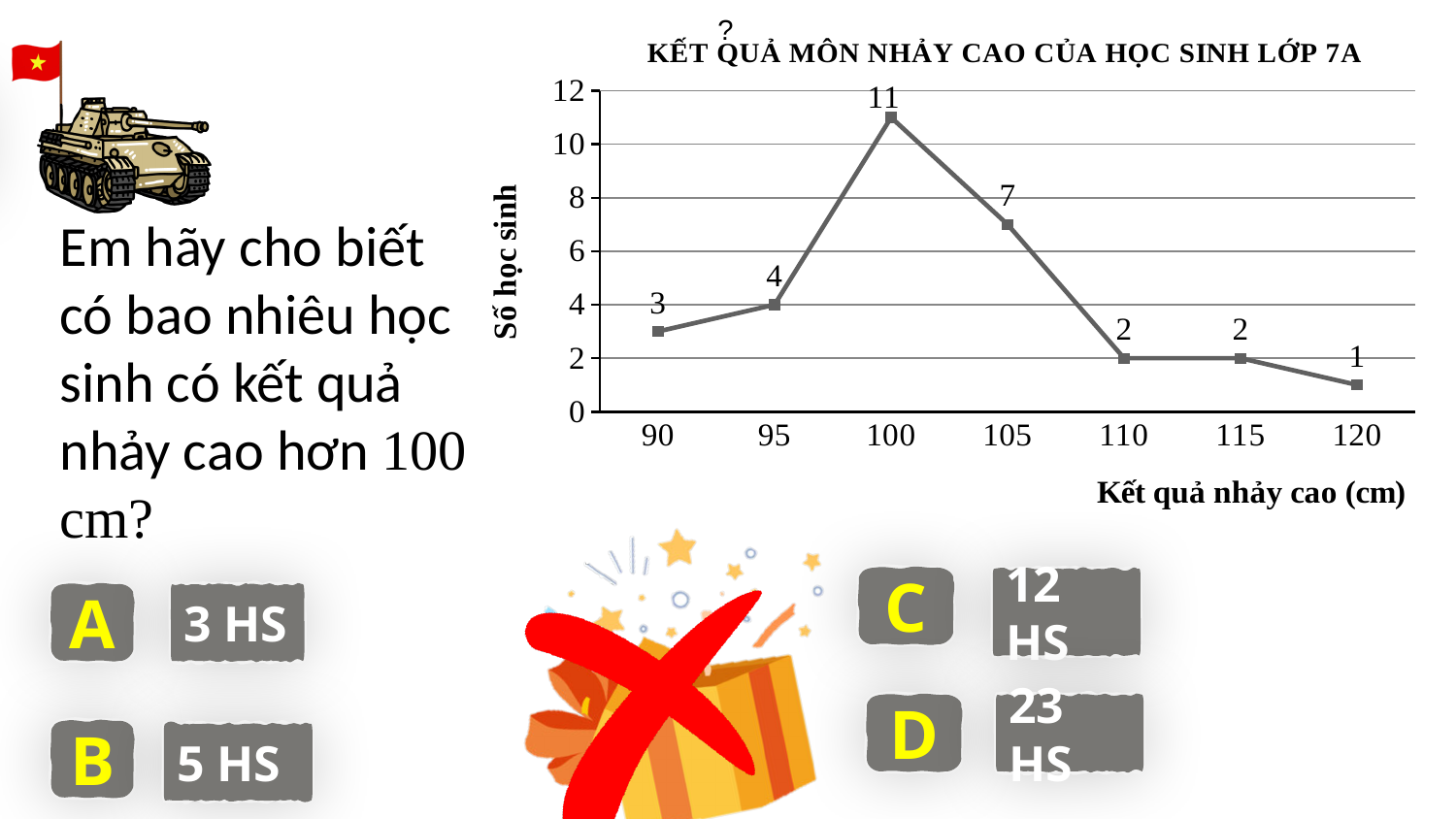
How many students achieved a high jump result of 120 cm? 1 How many high jump result categories are plotted on the x axis? 7 Which high jump result (cm) has the highest number of students? 100 What type of chart is shown on the slide? line chart What is the difference between the number of students at 100 cm and at 105 cm? 4 How many students achieved a high jump result of 105 cm? 7 Which high jump result (cm) has the lowest number of students? 120 Do the values rise or fall from 100 cm to 120 cm along the x axis? fall How many students achieved a high jump result of 100 cm? 11 Which has more students: the 95 cm result or the 105 cm result? 105 cm What is the label of the y axis of the chart? Số học sinh How many students achieved a high jump result of 90 cm? 3